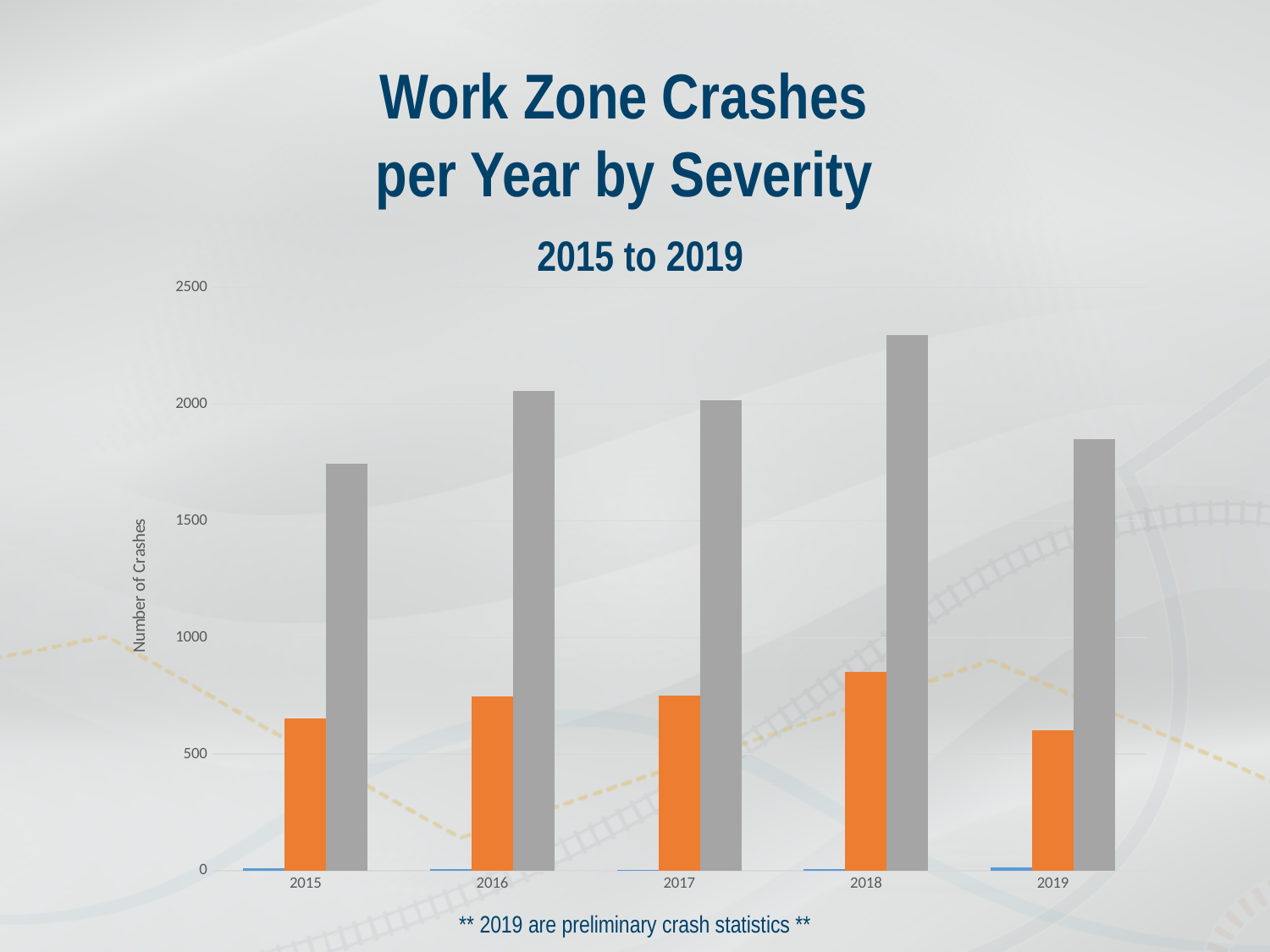
Is the value of the orange bar for 2018 greater or less than 1000? less Is the value of the gray bar for 2018 greater or less than 2000? greater Is the value of the orange bar for 2015 greater or less than 500? greater In which year is the gray bar the shortest? 2015 What is the label on the vertical axis of the chart? Number of Crashes In which year is the gray bar the tallest? 2018 In which year is the orange bar the tallest? 2018 Which is larger, the gray bar for 2018 or the gray bar for 2015? 2018 How many years are shown on the x axis of the chart? 5 What kind of chart is shown on the slide? Bar chart How many bars are plotted for each year in the chart? 3